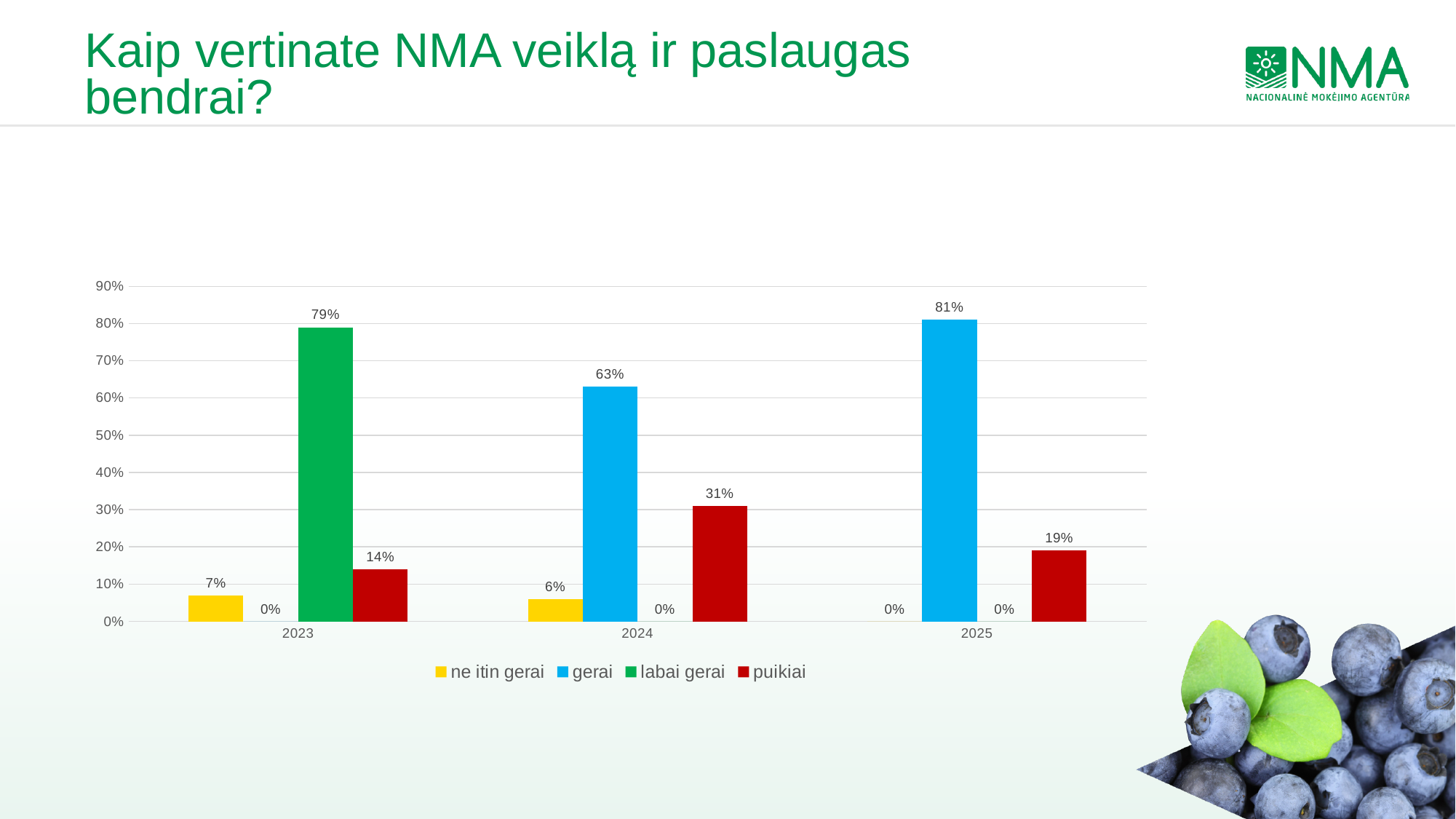
What is the difference between the "gerai" values in 2025 and 2024? 18% What kind of chart is shown on the slide? bar chart What is the value for "labai gerai" in 2023? 79% What is the value for "ne itin gerai" in 2024? 6% What is the value for "puikiai" in 2025? 19% Which is larger in 2023: "puikiai" or "ne itin gerai"? puikiai Which series is shown in red in the legend? puikiai How many series does the legend list? 4 In which year is the value for "puikiai" highest? 2024 What is the value for "gerai" in 2024? 63% How many year categories are shown on the x axis? 3 In which year is the value for "gerai" highest? 2025